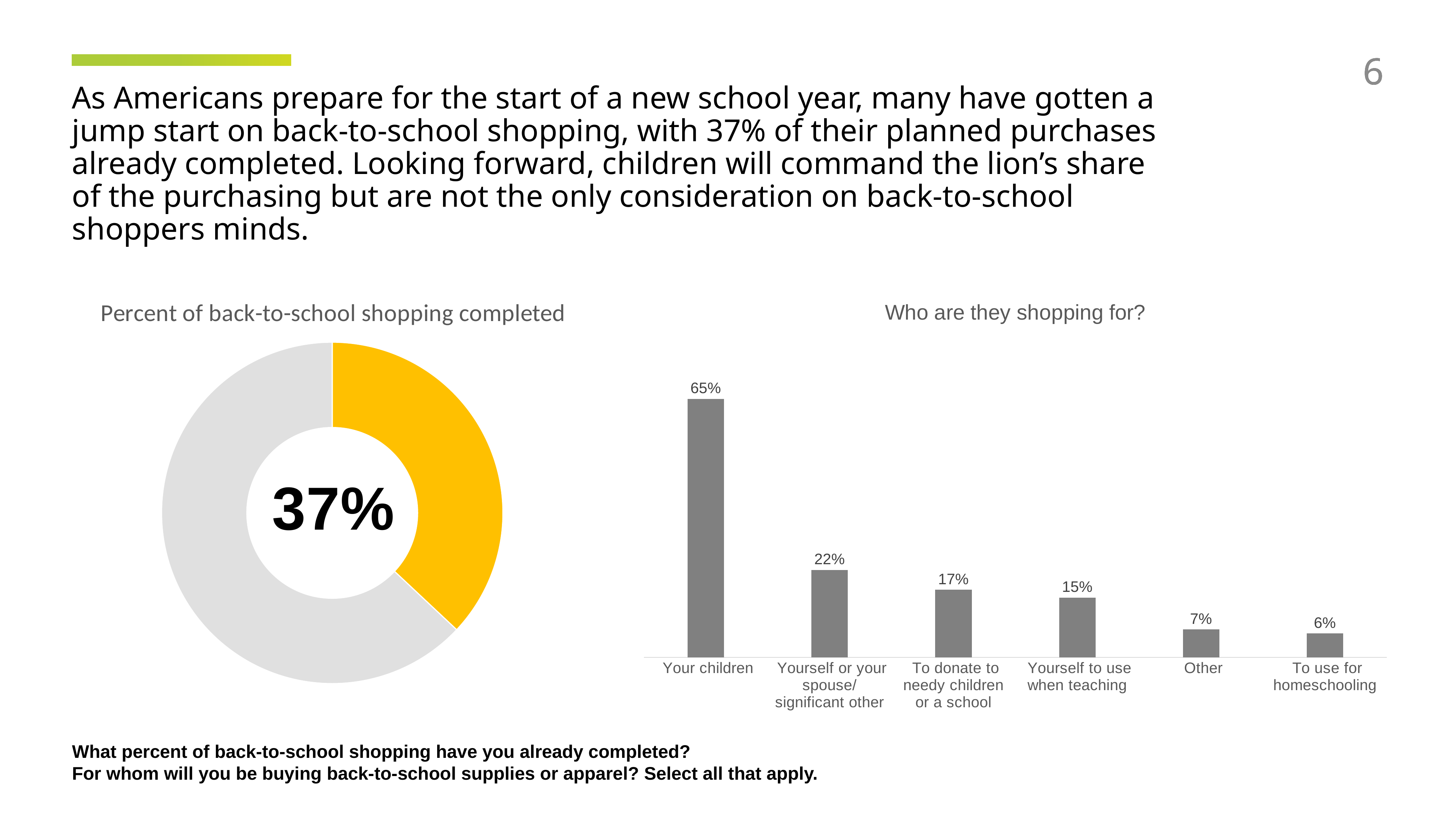
In the 'Who are they shopping for?' chart, what is the value for 'Yourself or your spouse/significant other'? 22% In the 'Who are they shopping for?' chart, which category has the lowest value? To use for homeschooling In the 'Who are they shopping for?' chart, what is the value for 'To donate to needy children or a school'? 17% What kind of chart is 'Percent of back-to-school shopping completed'? Donut chart In the 'Percent of back-to-school shopping completed' chart, what percent of back-to-school shopping is completed? 37% In the 'Who are they shopping for?' chart, which is larger: 'Yourself to use when teaching' or 'Other'? Yourself to use when teaching In the 'Who are they shopping for?' chart, which category has the highest value? Your children What kind of chart is 'Who are they shopping for?'? Bar chart How many categories are shown in the 'Who are they shopping for?' chart? 6 In the 'Who are they shopping for?' chart, what is the value for 'To use for homeschooling'? 6% In the 'Who are they shopping for?' chart, what is the value for 'Your children'? 65% In the 'Who are they shopping for?' chart, what is the difference between 'Your children' and 'Yourself or your spouse/significant other'? 43%